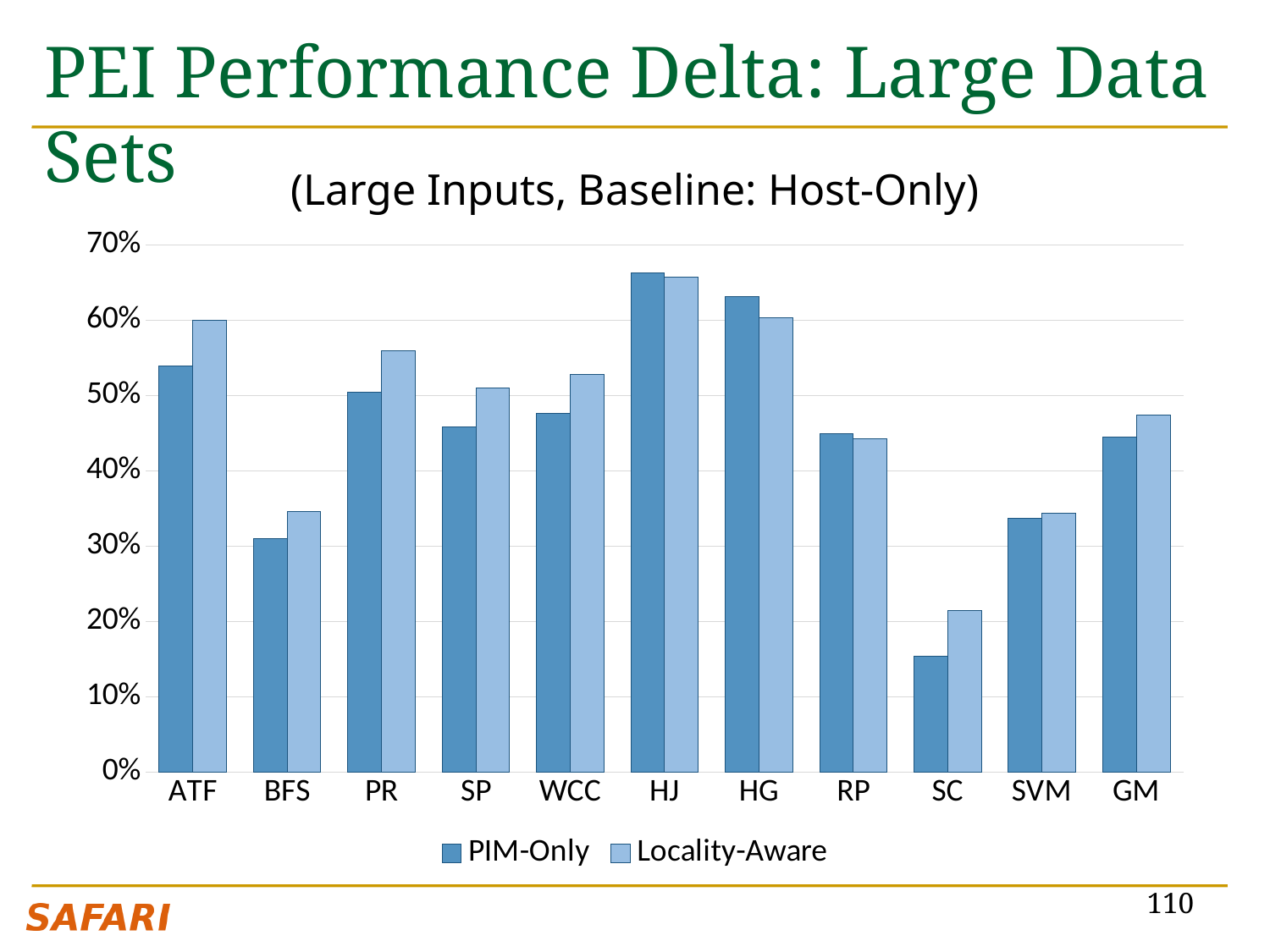
Is the PIM-Only value for SC greater or less than 20%? less Which category has the lowest Locality-Aware value? SC Is the PIM-Only value for HJ greater or less than 60%? greater Is the PIM-Only value for ATF greater or less than 50%? greater For ATF, which series has the larger value, PIM-Only or Locality-Aware? Locality-Aware Which category has the highest PIM-Only value? HJ How many series does the legend list? 2 How many categories are shown on the x axis? 11 What subtitle appears above the chart? (Large Inputs, Baseline: Host-Only) What kind of chart is shown on the slide? bar chart Which category has the lowest PIM-Only value? SC For HG, which series has the larger value, PIM-Only or Locality-Aware? PIM-Only